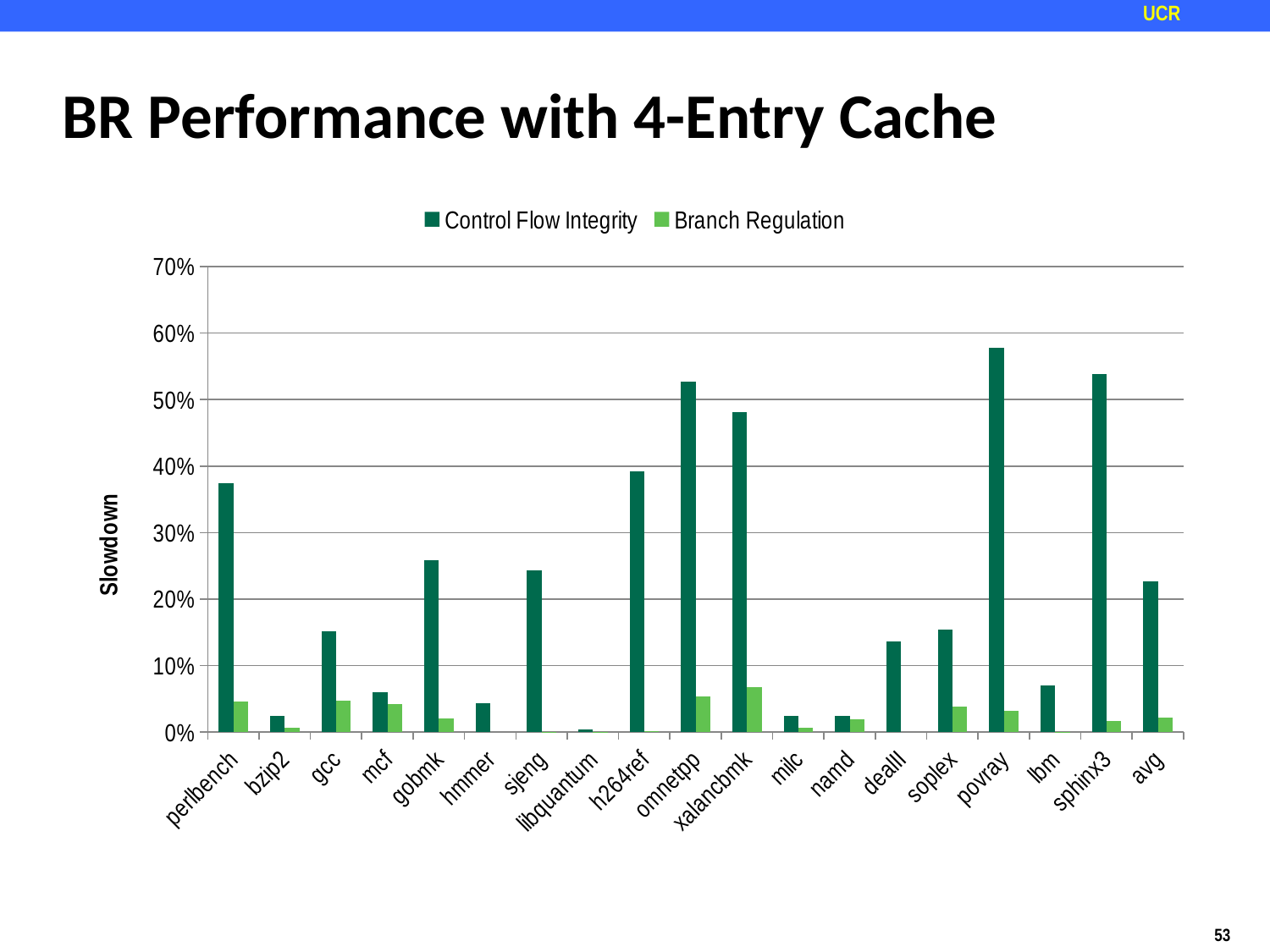
Which category has the lowest Control Flow Integrity slowdown? libquantum Is the Control Flow Integrity slowdown for avg greater or less than 20%? greater Is the Control Flow Integrity slowdown for omnetpp greater or less than 50%? greater What kind of chart is shown on the slide? bar chart Is the Control Flow Integrity slowdown for perlbench greater or less than 30%? greater How many benchmark categories are shown on the x axis? 19 Which has the larger Control Flow Integrity slowdown, omnetpp or xalancbmk? omnetpp How many series does the legend list? 2 What is the label of the y axis? Slowdown Which has the larger Control Flow Integrity slowdown, perlbench or h264ref? h264ref Which category has the highest Control Flow Integrity slowdown? povray